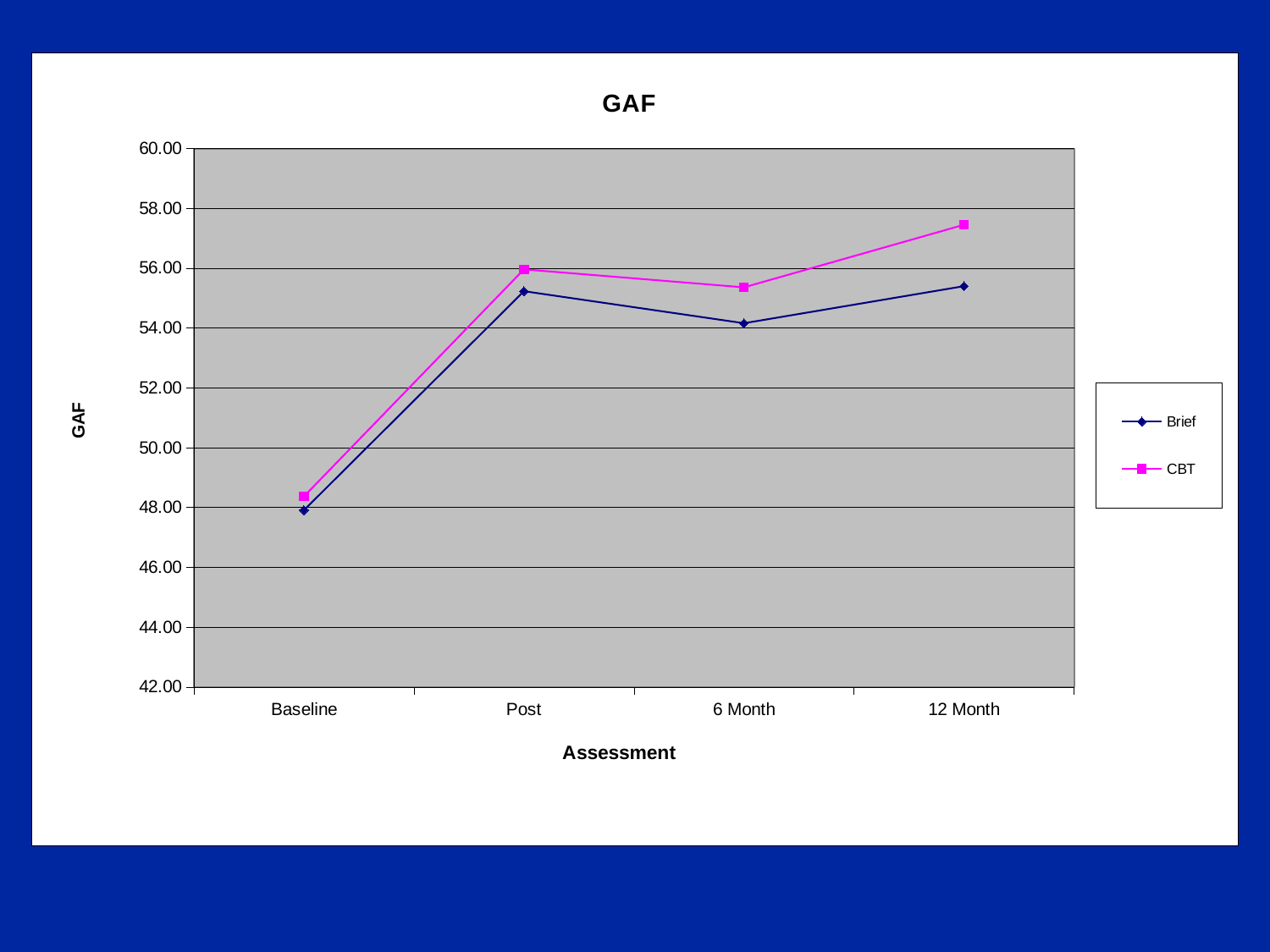
At 12 Month, which series has the larger value, Brief or CBT? CBT Is the value for CBT at 12 Month greater or less than 56.00? greater At 6 Month, which series has the larger value, Brief or CBT? CBT Is the value for CBT at Baseline greater or less than 50.00? less What is the title of the chart? GAF How many series does the legend list? 2 At which assessment point is the CBT series highest? 12 Month What is the x-axis title of the chart? Assessment At which assessment point is the Brief series lowest? Baseline Does the Brief series rise or fall from Baseline to Post? rise How many assessment points are plotted along the x axis? 4 What kind of chart is shown on the slide? line chart